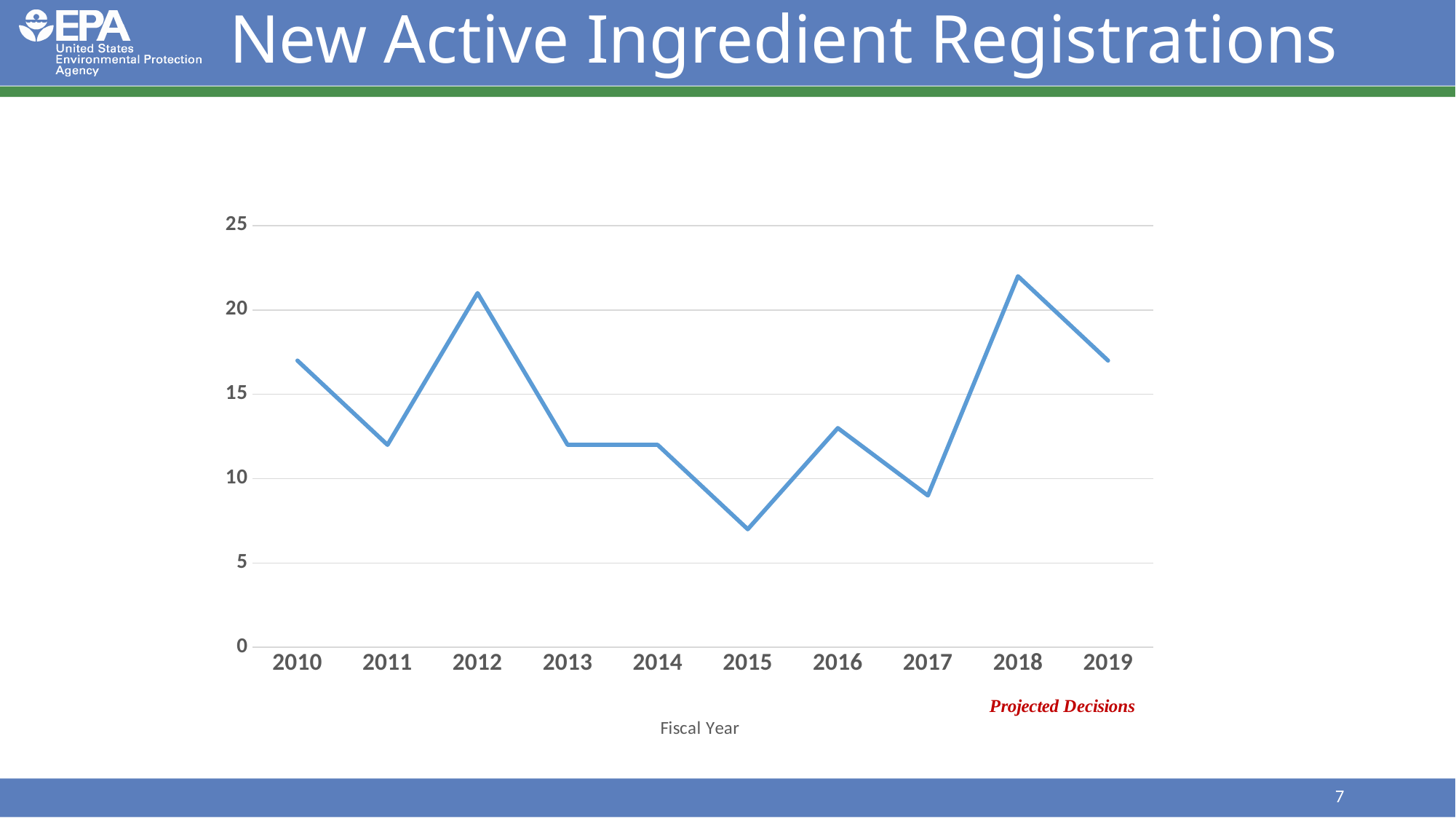
Is the value for 2018 greater or less than 20? greater Which fiscal year has the larger value, 2011 or 2012? 2012 What is the title of the x axis? Fiscal Year Is the value for 2015 greater or less than 10? less Is the value for 2010 greater or less than 15? greater Which fiscal year has the highest number of new active ingredient registrations? 2018 Does the line rise or fall from 2018 to 2019? fall Which fiscal year has the lowest number of new active ingredient registrations? 2015 What kind of chart is shown on the slide? line chart How many fiscal years are plotted on the x axis? 10